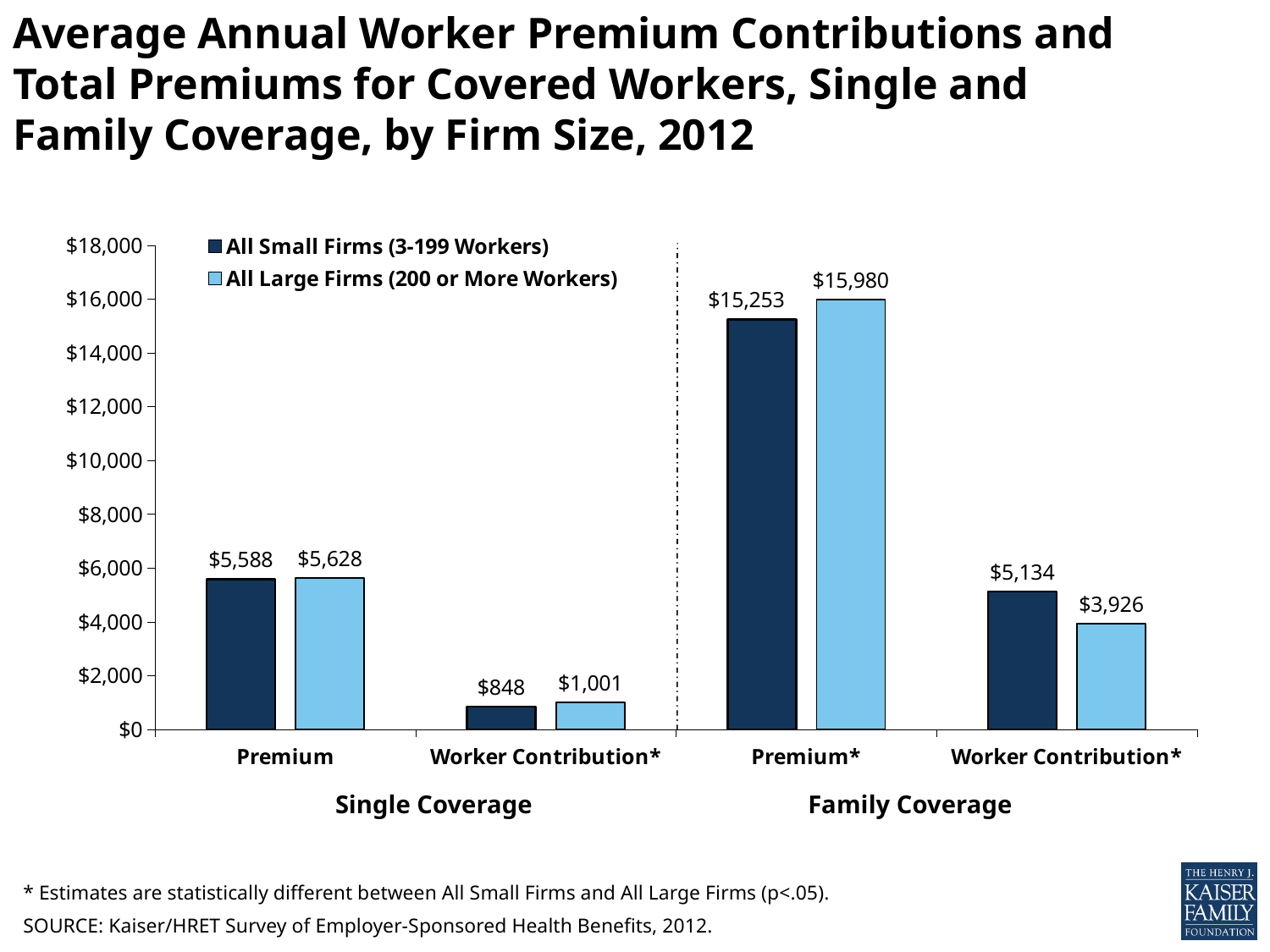
Which bar on the chart has the lowest value? Single Coverage Worker Contribution, All Small Firms ($848) For family coverage worker contribution, which is larger: all small firms or all large firms? All Small Firms Which bar on the chart has the highest value? Family Coverage Premium, All Large Firms ($15,980) What is the average annual premium for family coverage at all small firms? $15,253 What kind of chart is shown on the slide? Bar chart What is the difference between the family coverage worker contribution at small firms and at large firms? $1,208 What is the average annual premium for single coverage at all small firms (3-199 workers)? $5,588 What is the worker contribution for family coverage at all large firms (200 or more workers)? $3,926 What is the difference between the family coverage premium at large firms and at small firms? $727 What is the worker contribution for single coverage at all large firms? $1,001 Which colour represents All Large Firms (200 or More Workers) in the chart? Light blue How many series does the legend list? 2